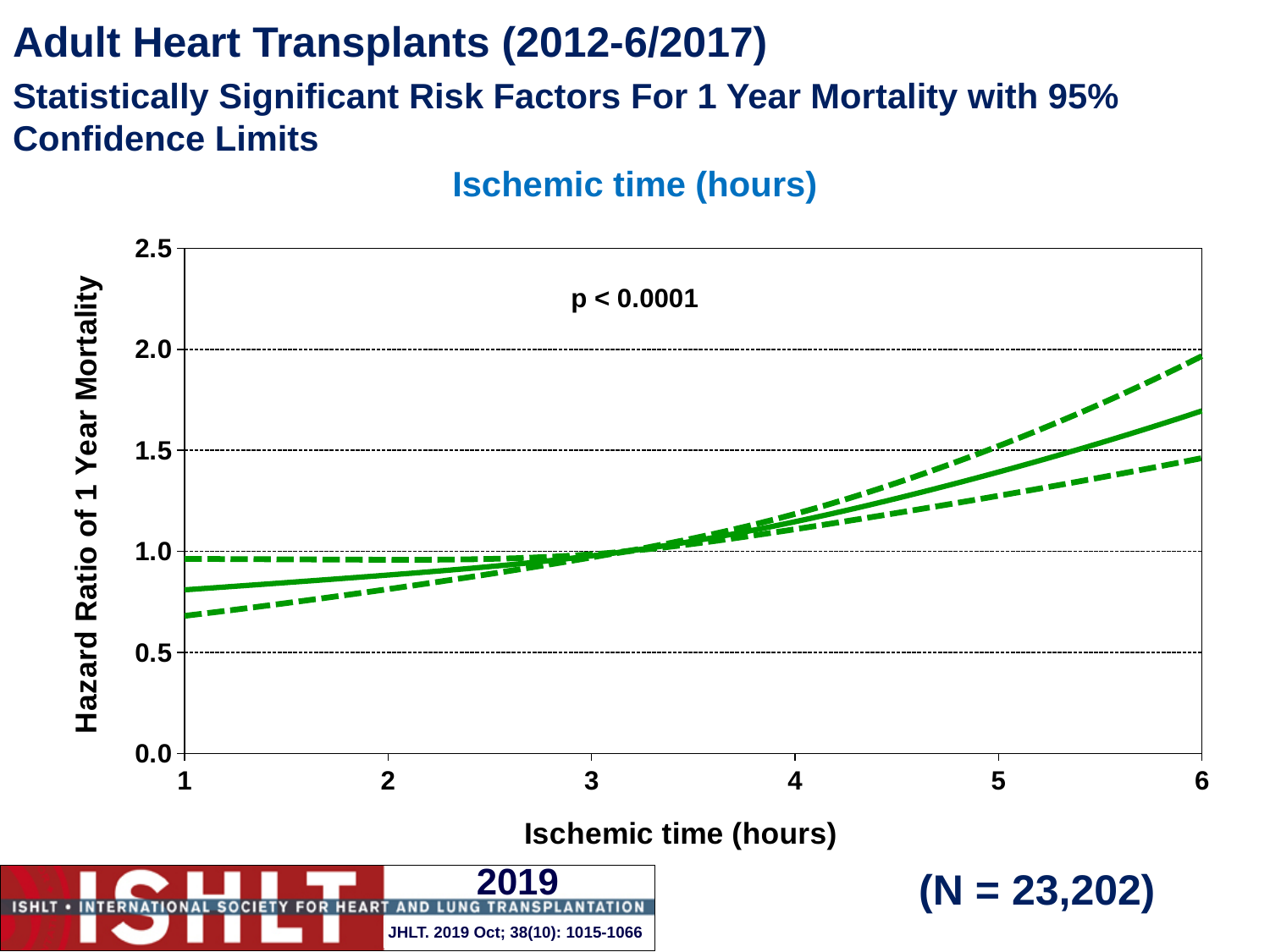
What is the label of the y axis of the chart? Hazard Ratio of 1 Year Mortality What kind of chart is shown on the slide? line chart Is the lower dashed confidence limit at 1 hour of ischemic time greater or less than 0.5? greater Is the hazard ratio on the solid line at 5 hours of ischemic time greater or less than 1.5? less Does the hazard ratio of 1 year mortality rise or fall as ischemic time increases from 1 to 6 hours? rise How many lines are plotted on the chart? 3 Is the hazard ratio on the solid line at 5 hours of ischemic time greater or less than 1.0? greater How many tick values are labelled on the x axis of the chart? 6 What is the p-value printed on the chart? p < 0.0001